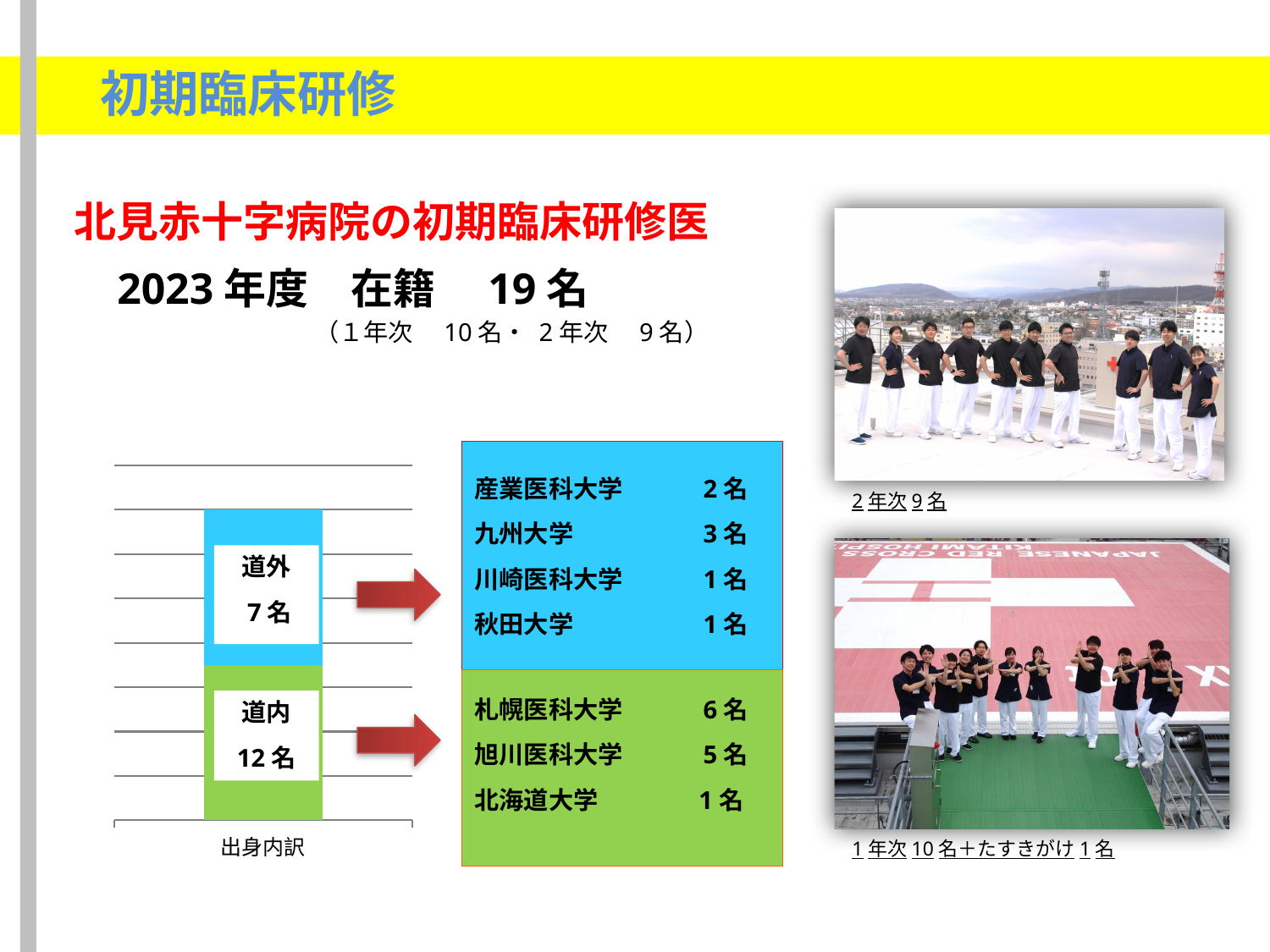
What is the total of the stacked bar (道外 plus 道内)? 19名 Which segment of the stacked bar has the smallest value? 道外 What is the difference between the 道内 and 道外 values in the stacked bar? 5名 How many segments make up the stacked bar? 2 Which segment is at the top of the stacked bar? 道外 Which segment of the stacked bar is larger, 道外 or 道内? 道内 What is the category label shown below the stacked bar? 出身内訳 Which colour is used for the 道内 segment of the stacked bar? green What is the value of the 道内 segment in the stacked bar? 12名 What is the value of the 道外 segment in the stacked bar? 7名 What kind of chart is shown on the slide? bar chart